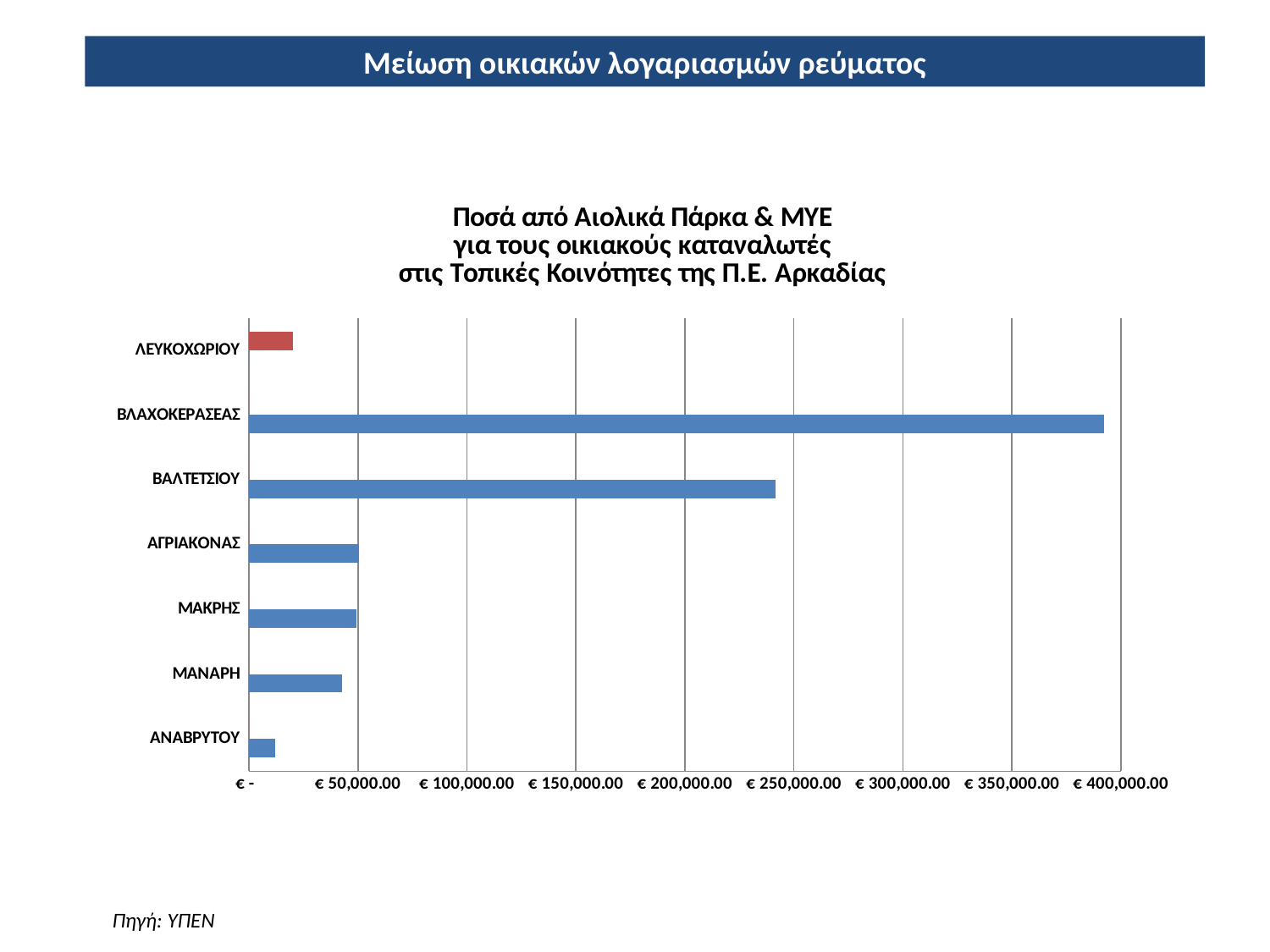
Is the value for ΑΝΑΒΡΥΤΟΥ greater or less than € 50,000.00? less Which is larger, the value for ΛΕΥΚΟΧΩΡΙΟΥ or the value for ΑΝΑΒΡΥΤΟΥ? ΛΕΥΚΟΧΩΡΙΟΥ Which community has the lowest amount in the chart? ΑΝΑΒΡΥΤΟΥ Which is larger, the value for ΒΑΛΤΕΤΣΙΟΥ or the value for ΜΑΝΑΡΗ? ΒΑΛΤΕΤΣΙΟΥ What kind of chart is shown on the slide? Bar chart Is the value for ΜΑΝΑΡΗ greater or less than € 50,000.00? less Is the value for ΒΑΛΤΕΤΣΙΟΥ greater or less than € 250,000.00? less Which community's bar is coloured red instead of blue? ΛΕΥΚΟΧΩΡΙΟΥ How many local communities (categories) are shown in the chart? 7 Which community has the highest amount in the chart? ΒΛΑΧΟΚΕΡΑΣΕΑΣ